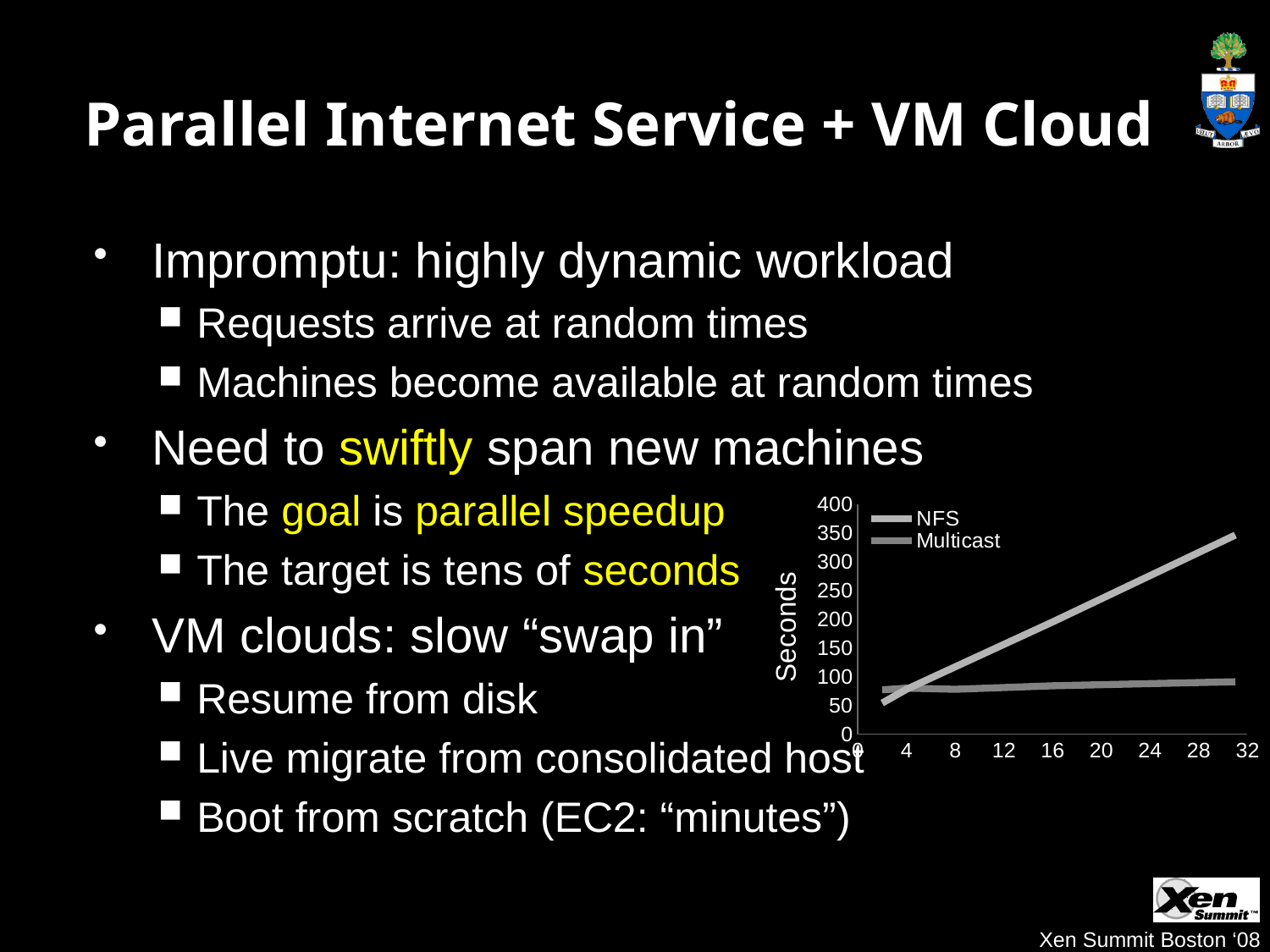
How many series does the chart's legend list? 2 Does the NFS line rise or fall as the x-axis value increases? rise Is the Multicast value at x = 16 greater or less than 200? less What kind of chart is shown on the slide? line chart What is the label on the chart's vertical axis? Seconds Is the Multicast value at x = 32 greater or less than 150? less Which series has the larger value at x = 32, NFS or Multicast? NFS What is the highest value shown on the chart's vertical axis? 400 What are the two series named in the chart's legend? NFS and Multicast How many tick labels are shown on the chart's horizontal axis? 9 Is the NFS value at x = 24 greater or less than 200? greater